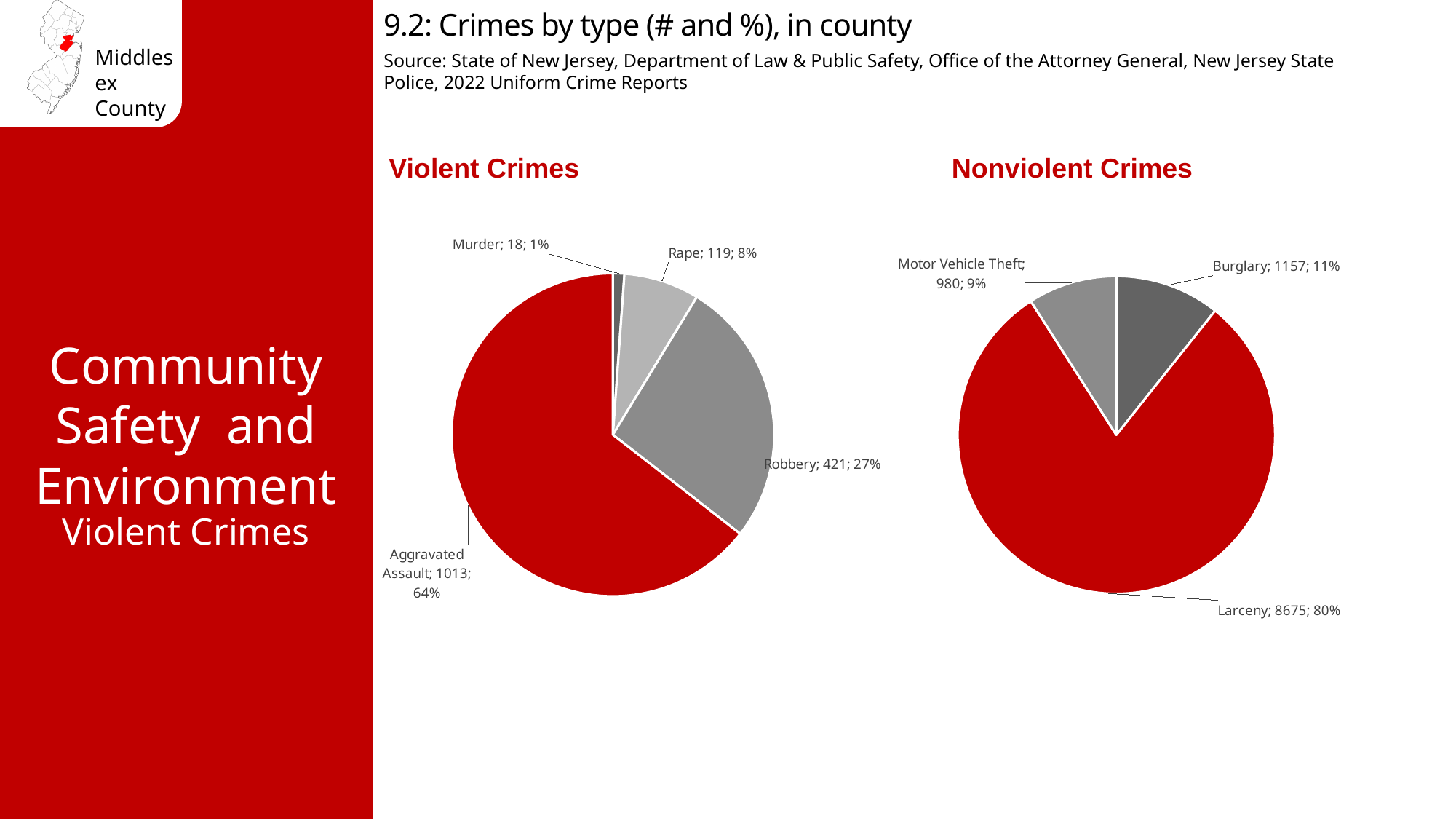
In the Violent Crimes chart, what is the difference between the Robbery count and the Rape count? 302 In the Violent Crimes chart, which category has the largest slice? Aggravated Assault In the Nonviolent Crimes chart, what percentage share is shown for Larceny? 80% In the Nonviolent Crimes chart, how many crimes are labelled for Motor Vehicle Theft? 980 In the Nonviolent Crimes chart, which is larger, Burglary or Motor Vehicle Theft? Burglary In the Violent Crimes chart, which category has the smallest slice? Murder In the Violent Crimes chart, how many categories are shown? 4 What is the title of the chart on the left side of the slide? Violent Crimes In the Violent Crimes chart, what percentage share is shown for Aggravated Assault? 64% In the Violent Crimes chart, how many crimes are labelled for Robbery? 421 What type of chart is used for the Nonviolent Crimes chart? Pie chart In the Nonviolent Crimes chart, what is the difference between the Larceny count and the Burglary count? 7518